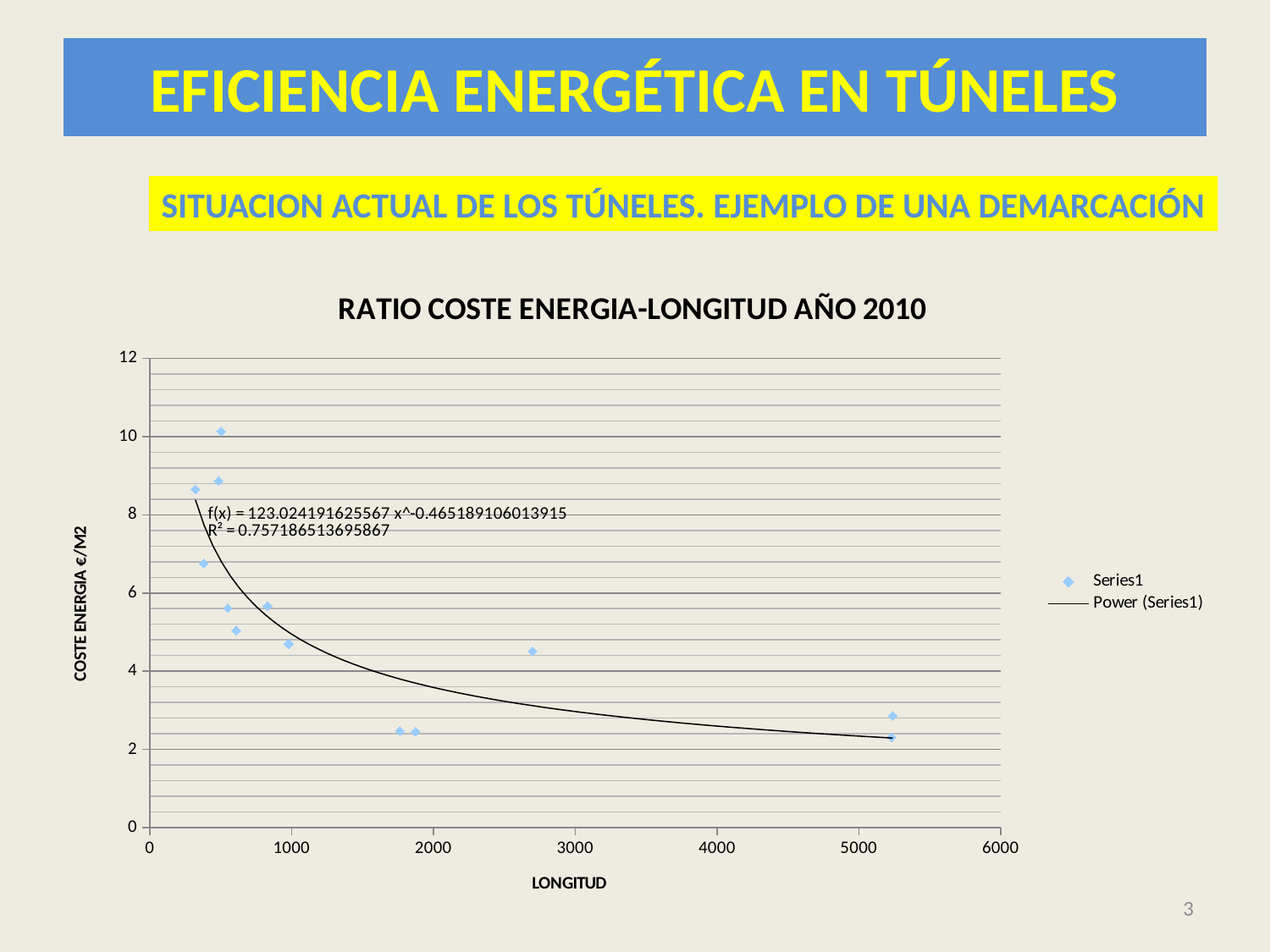
What R² value is printed on the chart for the trendline? 0.757186513695867 How many entries does the chart legend list? 2 What kind of chart is shown on the slide? scatter chart Is the COSTE ENERGIA value of the point near LONGITUD 2700 greater or less than 4? greater Which has the higher COSTE ENERGIA value: the highest point near LONGITUD 500 or the point near LONGITUD 2700? the point near LONGITUD 500 Are the COSTE ENERGIA values of the points near LONGITUD 1800 greater or less than 4? less Is the highest plotted point's COSTE ENERGIA value greater or less than 10? greater What is the maximum value shown on the vertical axis? 12 Do the plotted values generally rise or fall as LONGITUD increases along the x axis? fall What is the title of the chart? RATIO COSTE ENERGIA-LONGITUD AÑO 2010 What is the label of the vertical axis? COSTE ENERGIA €/M2 What is the maximum value shown on the horizontal axis? 6000